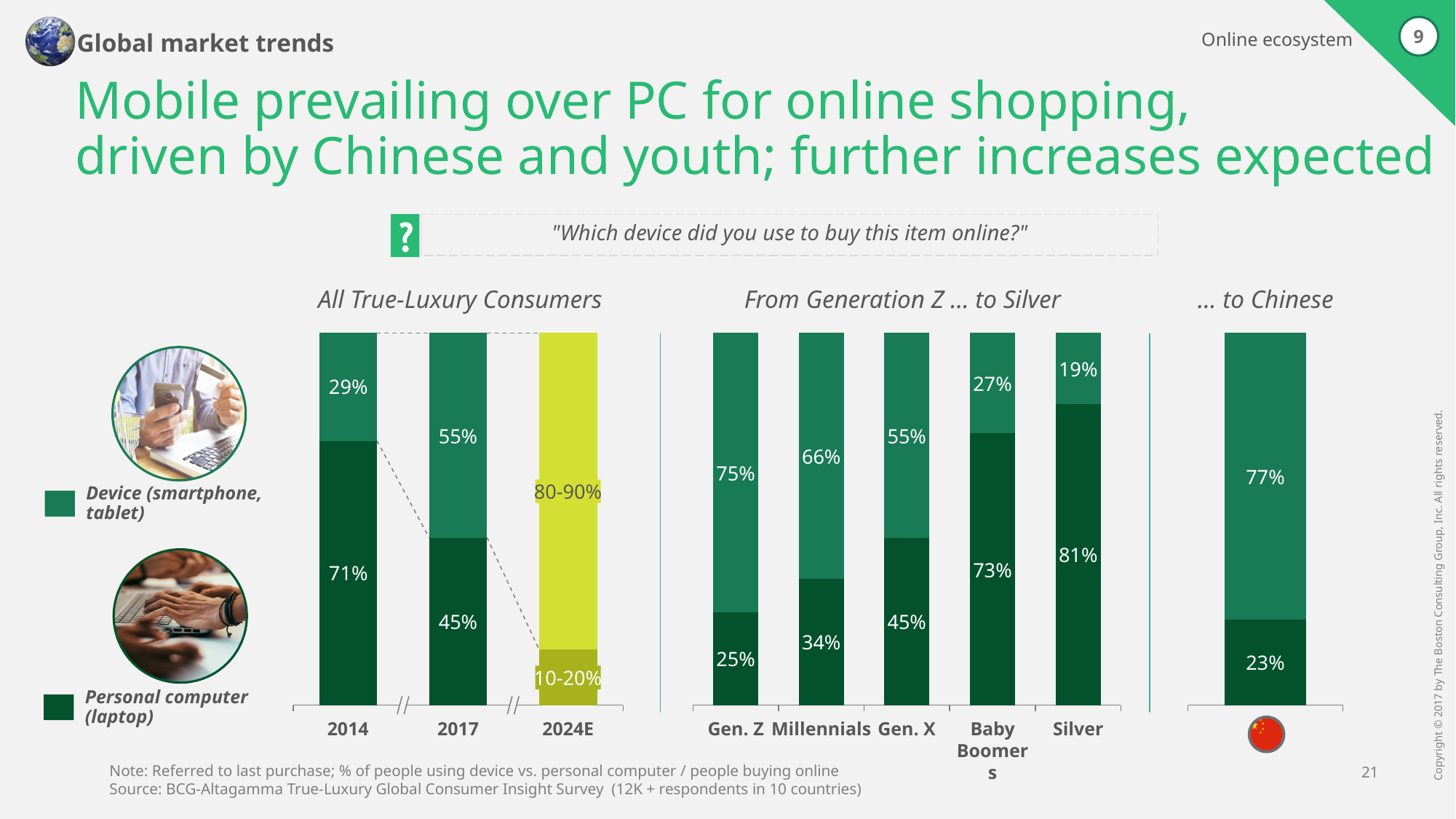
In the 'From Generation Z ... to Silver' chart, what is the difference between the device share of Gen. Z and the device share of Gen. X? 20% How many series does the legend on the slide list? 2 In the 'From Generation Z ... to Silver' chart, what share of Millennials used a device (smartphone, tablet)? 66% In the 'From Generation Z ... to Silver' chart, which generation has the lowest device (smartphone, tablet) share? Silver In the '... to Chinese' chart, which is larger: the device (smartphone, tablet) share or the personal computer (laptop) share? Device (smartphone, tablet) In the 'All True-Luxury Consumers' chart, what share of consumers used a personal computer (laptop) in 2017? 45% What kind of chart is the 'All True-Luxury Consumers' chart? Stacked bar chart In the 'From Generation Z ... to Silver' chart, how many generation categories are shown? 5 In the 'All True-Luxury Consumers' chart, does the device (smartphone, tablet) share rise or fall from 2014 to 2024E? Rise In the 'All True-Luxury Consumers' chart, what share of consumers used a device (smartphone, tablet) in 2014? 29% In the 'All True-Luxury Consumers' chart, what is the expected device (smartphone, tablet) share for 2024E? 80-90% In the 'From Generation Z ... to Silver' chart, which generation has the highest personal computer (laptop) share? Silver